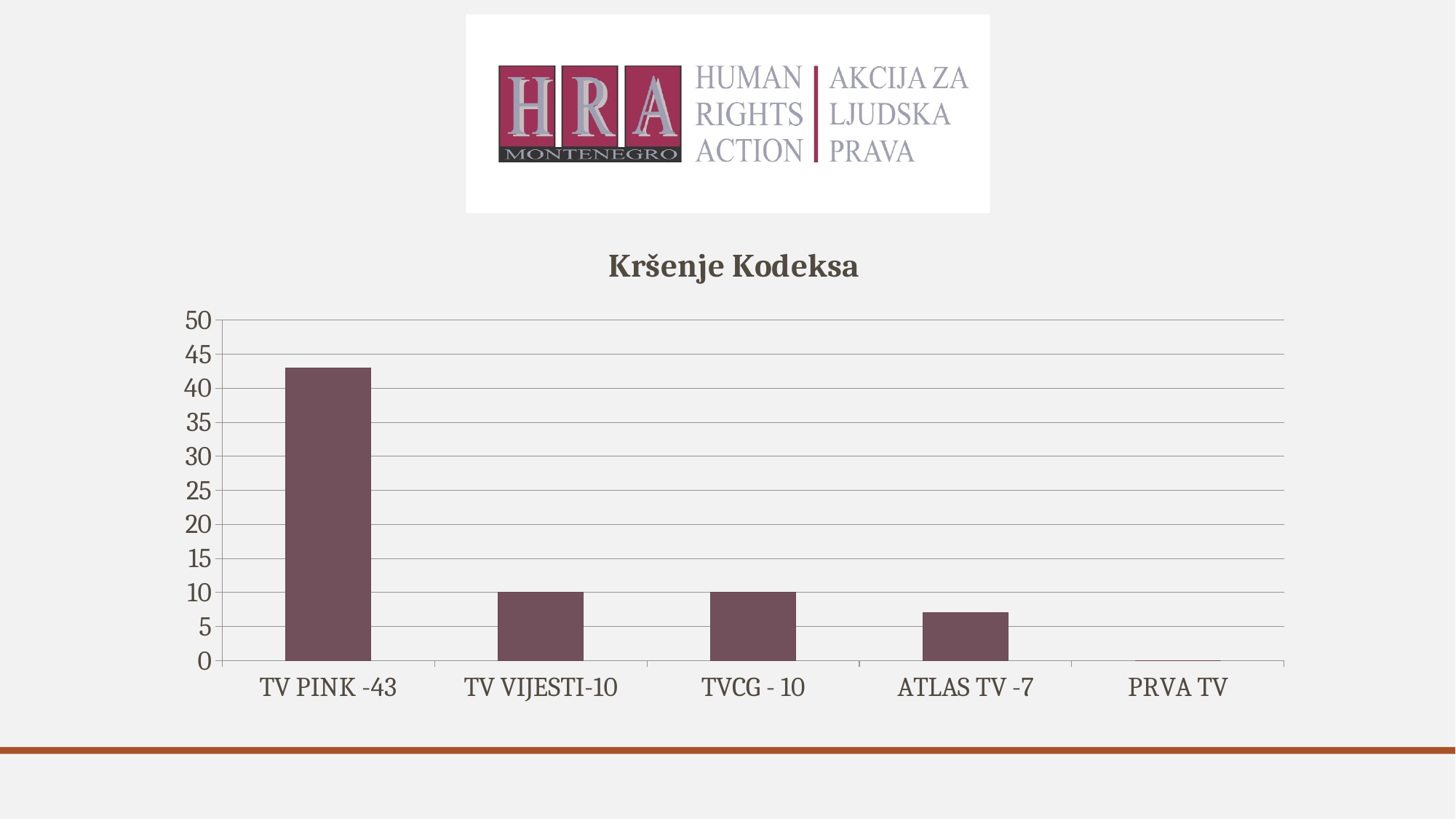
Is the value for TV PINK greater or less than 40? greater How many categories are shown on the x axis of the chart? 5 Is the value for ATLAS TV greater or less than 10? less What is the value for ATLAS TV? 7 Which category has the highest value? TV PINK Which category has the lowest value? PRVA TV What is the value for TV VIJESTI? 10 Which is larger, the value for TVCG or the value for ATLAS TV? TVCG What is the value for TV PINK? 43 What is the difference between the values for TV PINK and TVCG? 33 What is the title of the chart? Kršenje Kodeksa What type of chart is shown on the slide? bar chart